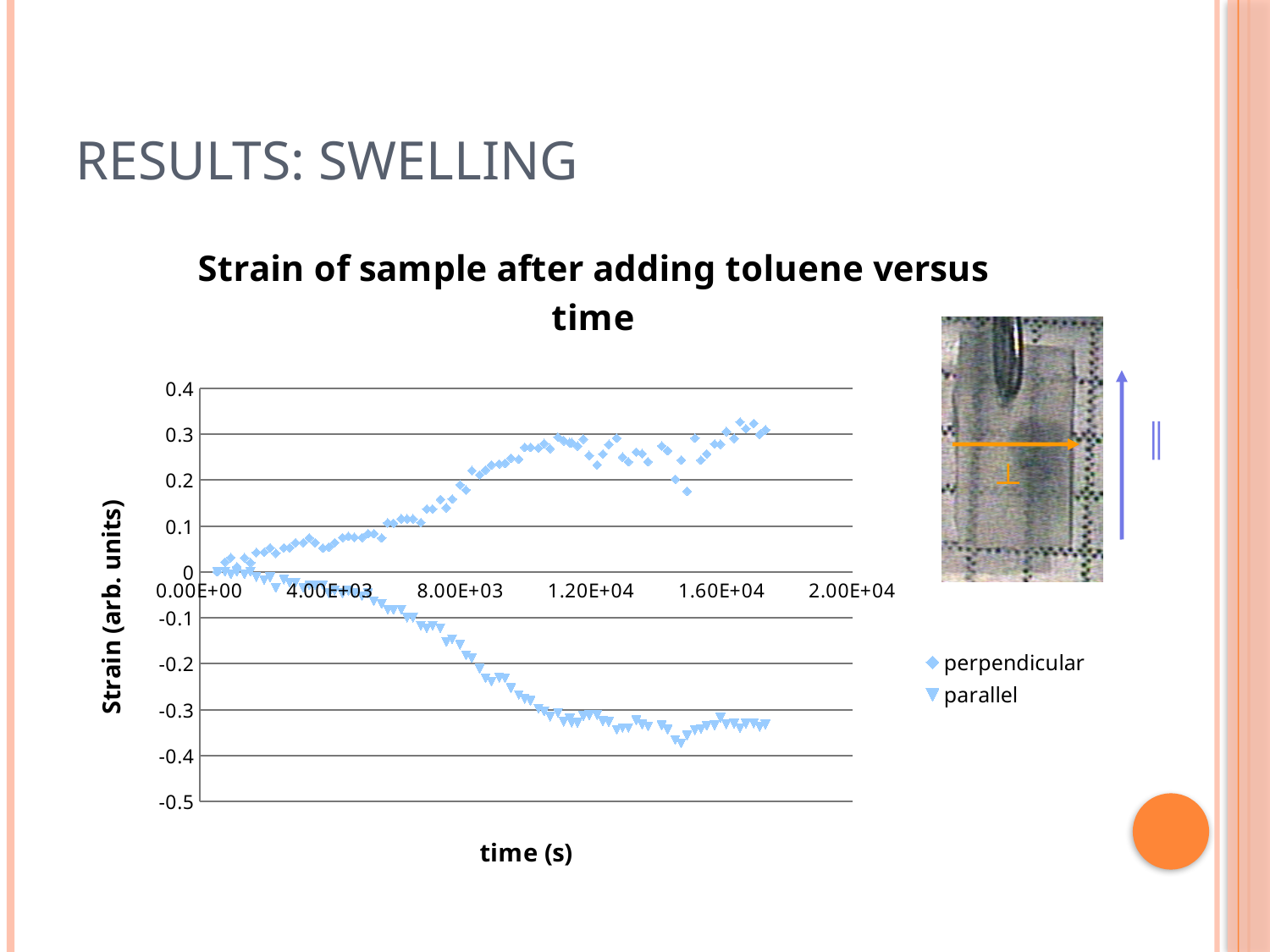
What is the title of the chart? Strain of sample after adding toluene versus time What kind of chart is shown on the slide? scatter chart Does the parallel strain rise or fall as time increases? fall Is the parallel strain at 8.00E+03 s greater or less than 0? less Is the parallel strain at 1.20E+04 s greater or less than -0.2? less Is the perpendicular strain at 4.00E+03 s greater or less than 0? greater What are the two series named in the legend? perpendicular and parallel Does the perpendicular strain rise or fall as time increases? rise How many series does the legend list? 2 At 1.60E+04 s, which series has the higher strain, perpendicular or parallel? perpendicular